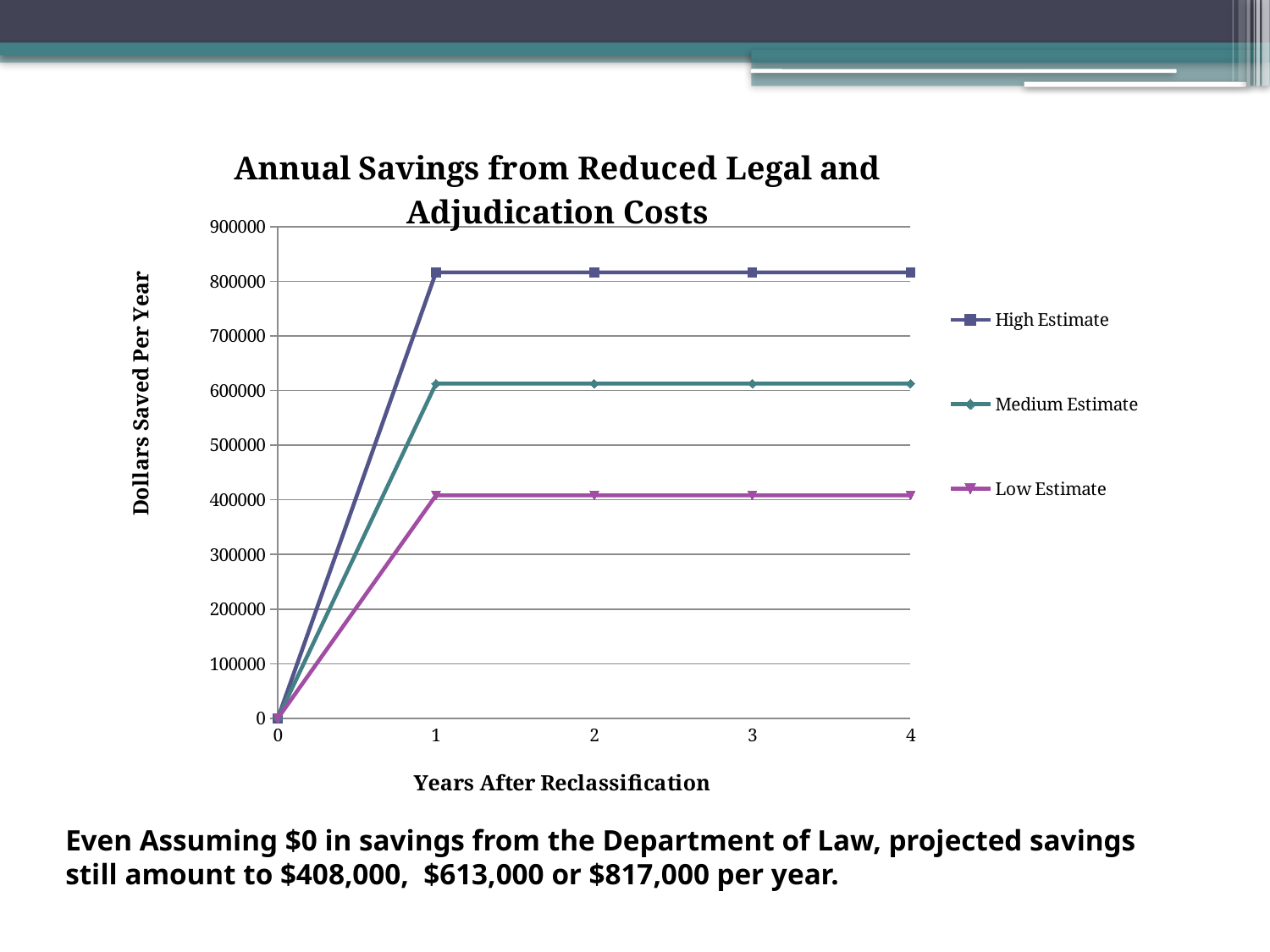
Is the High Estimate value at year 2 greater or less than 700000? greater How many series does the legend list? 3 Is the Low Estimate value at year 1 greater or less than 500000? less Is the Medium Estimate value at year 3 greater or less than 500000? greater From year 1 to year 4, does the Medium Estimate rise, fall, or stay flat? stay flat Which series has the lowest value at year 3? Low Estimate How many points along the x axis (Years After Reclassification) are plotted for each series? 5 What kind of chart is shown on the slide? line chart At year 4, which is larger: the High Estimate or the Low Estimate? High Estimate Which series has the highest value at year 2? High Estimate What is the value of the High Estimate at year 0? 0 What is the title of the y axis? Dollars Saved Per Year